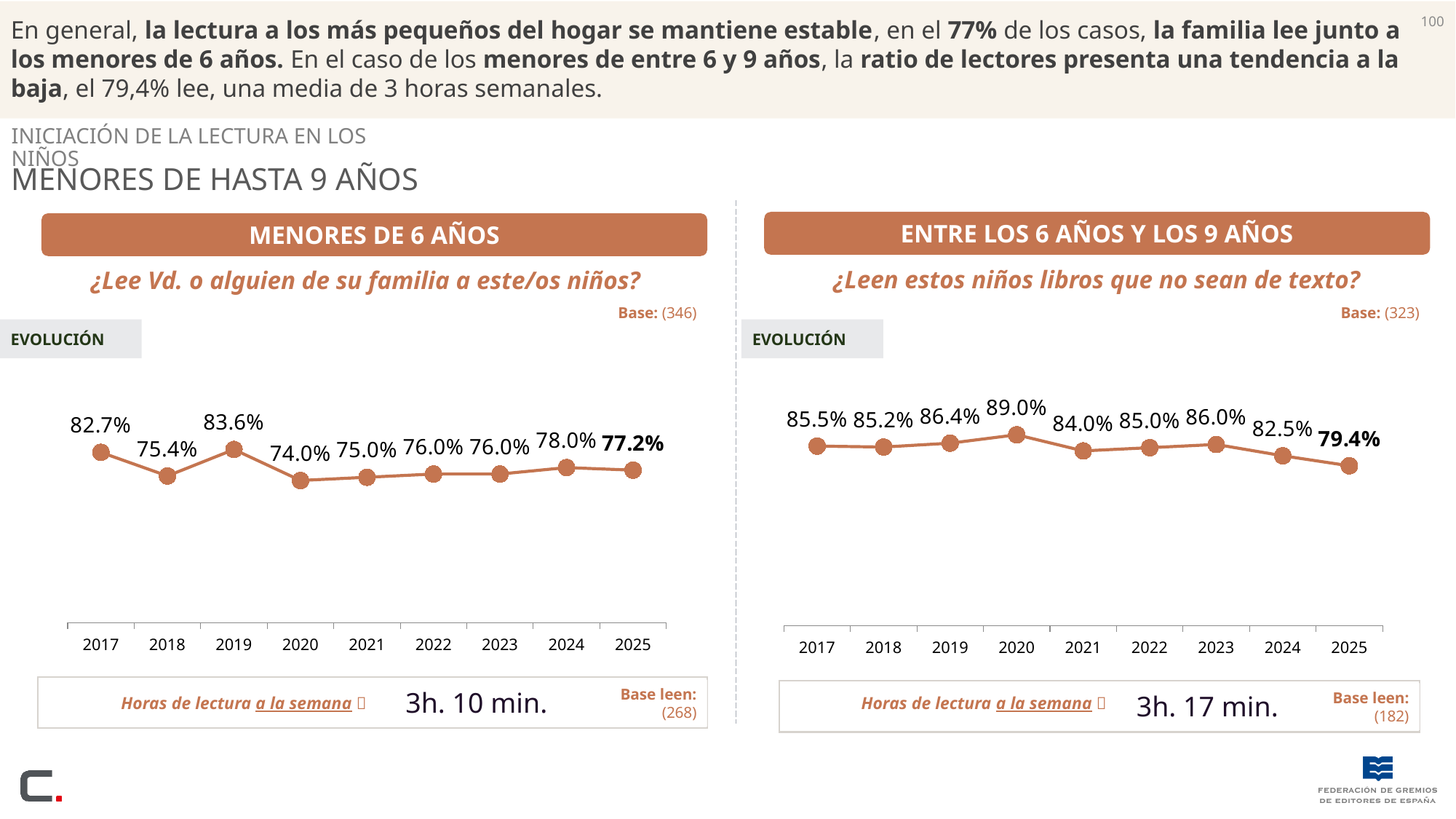
How many years are plotted in the 'MENORES DE 6 AÑOS' chart? 9 What kind of chart is used in the 'ENTRE LOS 6 AÑOS Y LOS 9 AÑOS' panel? Line chart In the 'MENORES DE 6 AÑOS' chart, which year has the lowest value? 2020 In the 'MENORES DE 6 AÑOS' chart, which year has the highest value? 2019 In the 'MENORES DE 6 AÑOS' chart, what is the difference between the 2017 and 2018 values? 7.3 percentage points In the 'ENTRE LOS 6 AÑOS Y LOS 9 AÑOS' chart, is the value for 2023 larger or smaller than the value for 2024? larger In the 'ENTRE LOS 6 AÑOS Y LOS 9 AÑOS' chart, what is the difference between the 2020 and 2025 values? 9.6 percentage points In the 'ENTRE LOS 6 AÑOS Y LOS 9 AÑOS' chart, which year has the lowest value? 2025 In the 'MENORES DE 6 AÑOS' chart, what is the value for 2019? 83.6% In the 'ENTRE LOS 6 AÑOS Y LOS 9 AÑOS' chart, what is the value for 2020? 89.0% In the 'ENTRE LOS 6 AÑOS Y LOS 9 AÑOS' chart, what is the value for 2025? 79.4% In the 'MENORES DE 6 AÑOS' chart, what is the value for 2025? 77.2%